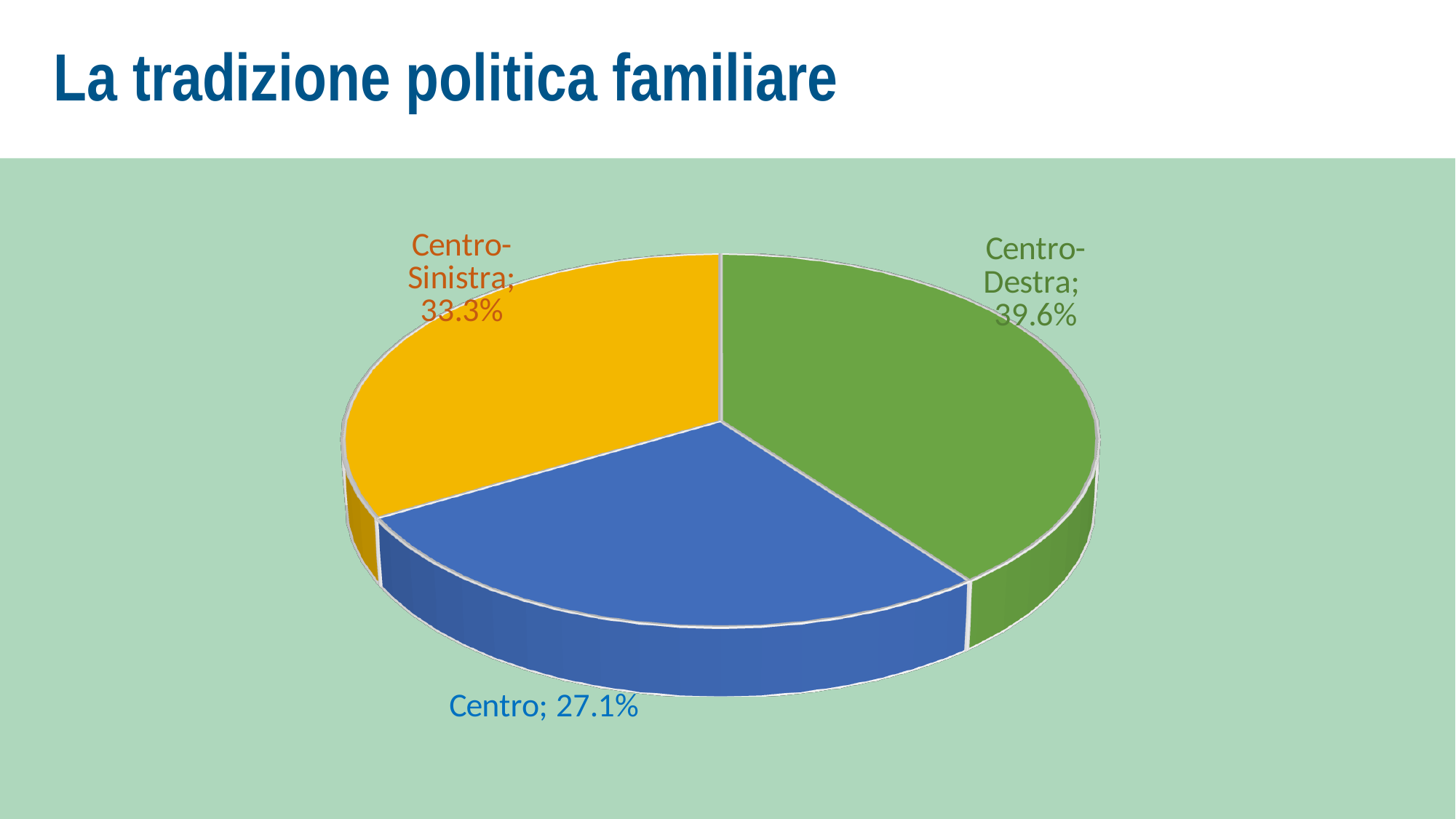
What share of the pie does Centro hold? 27.1% What is the title of the slide? La tradizione politica familiare Which category has the smallest slice of the pie? Centro Which is larger, the share for Centro-Sinistra or the share for Centro? Centro-Sinistra What share of the pie does Centro-Sinistra hold? 33.3% What share of the pie does Centro-Destra hold? 39.6% Which category has the largest slice of the pie? Centro-Destra What is the difference in percentage points between Centro-Sinistra and Centro? 6.2 What colour is the Centro slice? Blue What is the difference in percentage points between Centro-Destra and Centro? 12.5 What kind of chart is shown on the slide? Pie chart How many slices does the pie chart have? 3